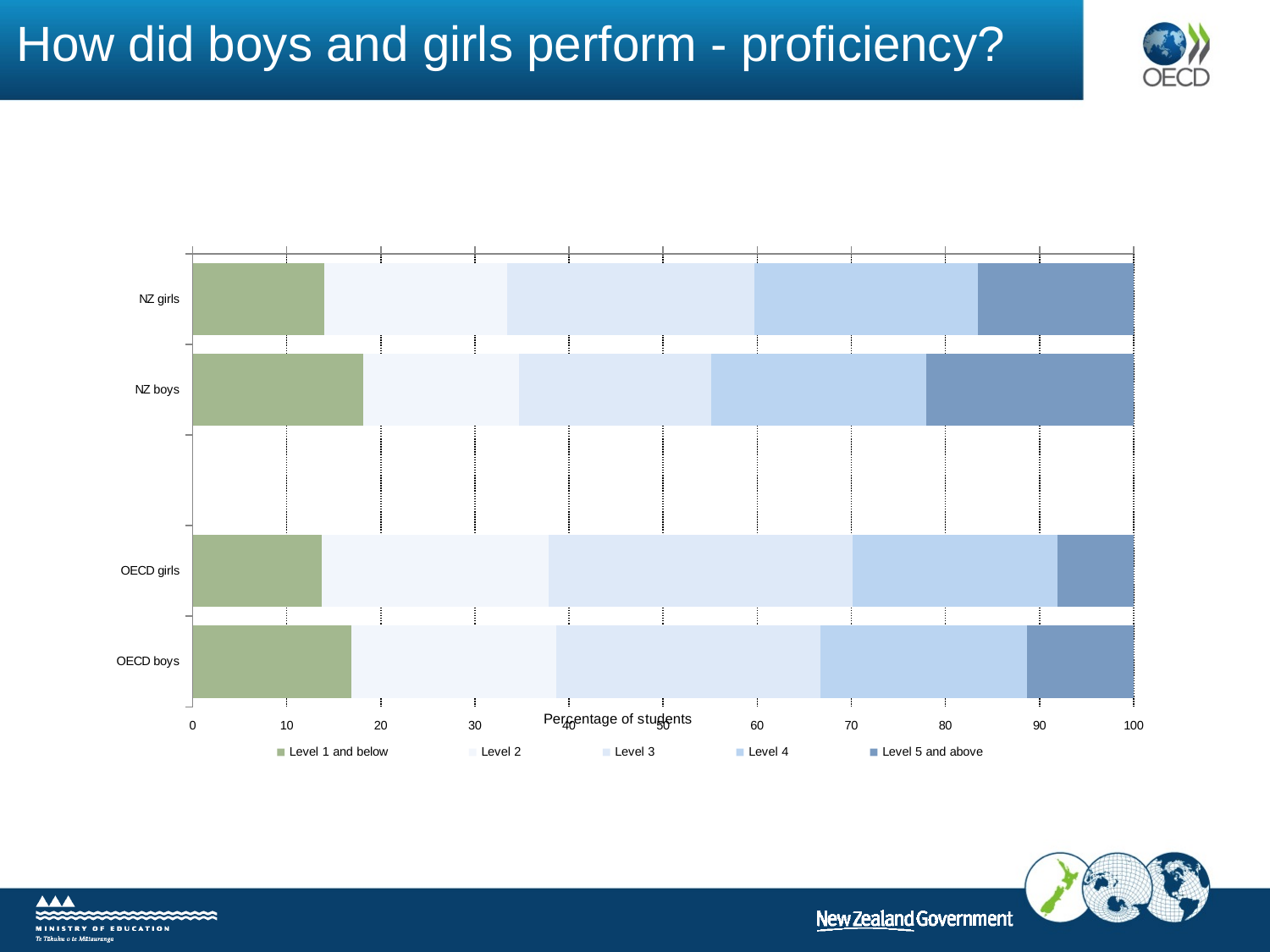
How many series does the legend list? 5 Is the Level 5 and above value for OECD girls greater or less than 10? less Which has a larger Level 5 and above segment, NZ boys or OECD boys? NZ boys Is the Level 1 and below value for NZ girls greater or less than 10? greater Is the Level 1 and below value for NZ boys greater or less than 20? less What kind of chart is shown on the slide? Stacked bar chart How many labelled categories are plotted on the vertical axis? 4 Which category has the largest Level 5 and above segment? NZ boys What is the title of the horizontal axis? Percentage of students Which legend entry is shown in green? Level 1 and below Which has a larger Level 3 segment, OECD girls or NZ girls? OECD girls Which category has the smallest Level 5 and above segment? OECD girls